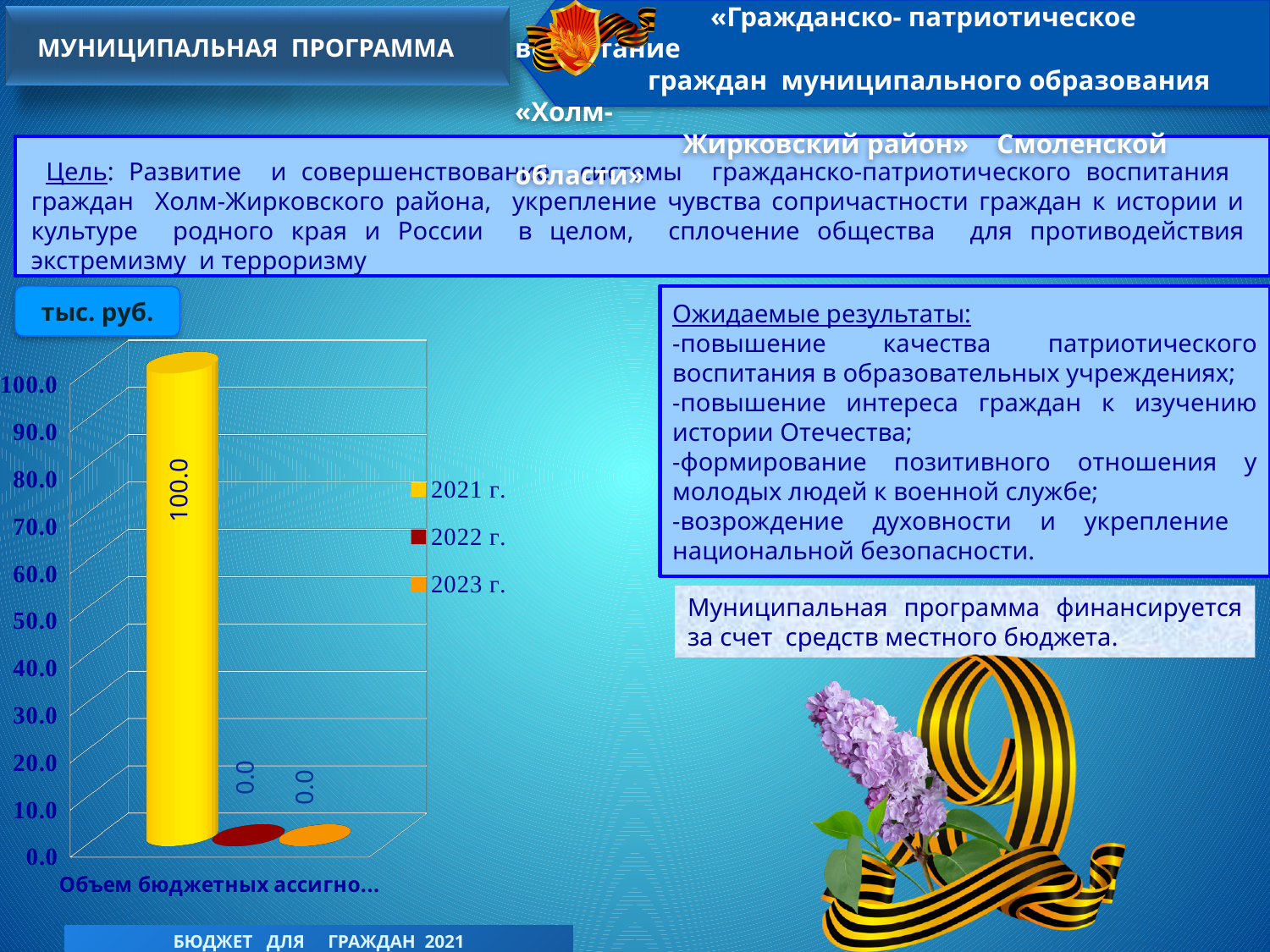
Which year has the highest value in the chart? 2021 г. How many series does the legend list? 3 Which is larger, the value for 2021 г. or the value for 2023 г.? 2021 г. What is the value for 2021 г. in the chart? 100.0 What is the value for 2023 г. in the chart? 0.0 What kind of chart is shown on the slide? bar chart What is the difference between the values for 2021 г. and 2022 г.? 100.0 What unit is indicated for the chart values? тыс. руб. What is the highest tick value shown on the vertical axis of the chart? 100.0 What is the value for 2022 г. in the chart? 0.0 What colour is the bar for 2021 г.? yellow Is the value for 2021 г. greater or less than 50.0? greater